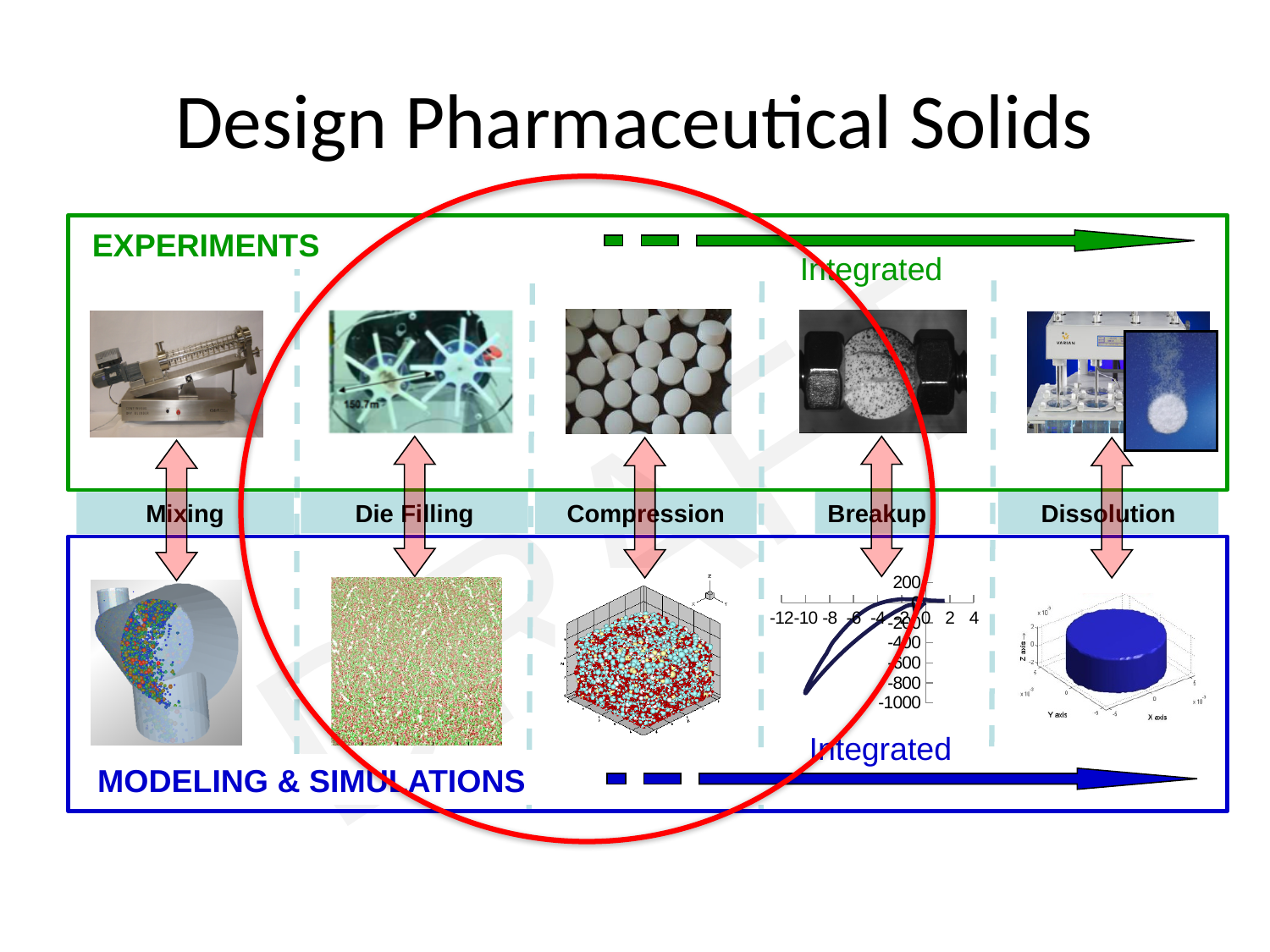
In the Breakup line chart, is the plotted value at x = -10 greater or less than -400? less What is the lowest tick value shown on the y axis of the Breakup line chart? -1000 What is the highest tick value shown on the y axis of the Breakup line chart? 200 In the Breakup line chart, is the plotted value at x = 0 greater or less than -400? greater In the Breakup line chart, do the plotted values rise or fall as the x axis increases from -12 to 4? rise What kind of chart is shown under the Breakup step in the Modeling & Simulations row? line chart